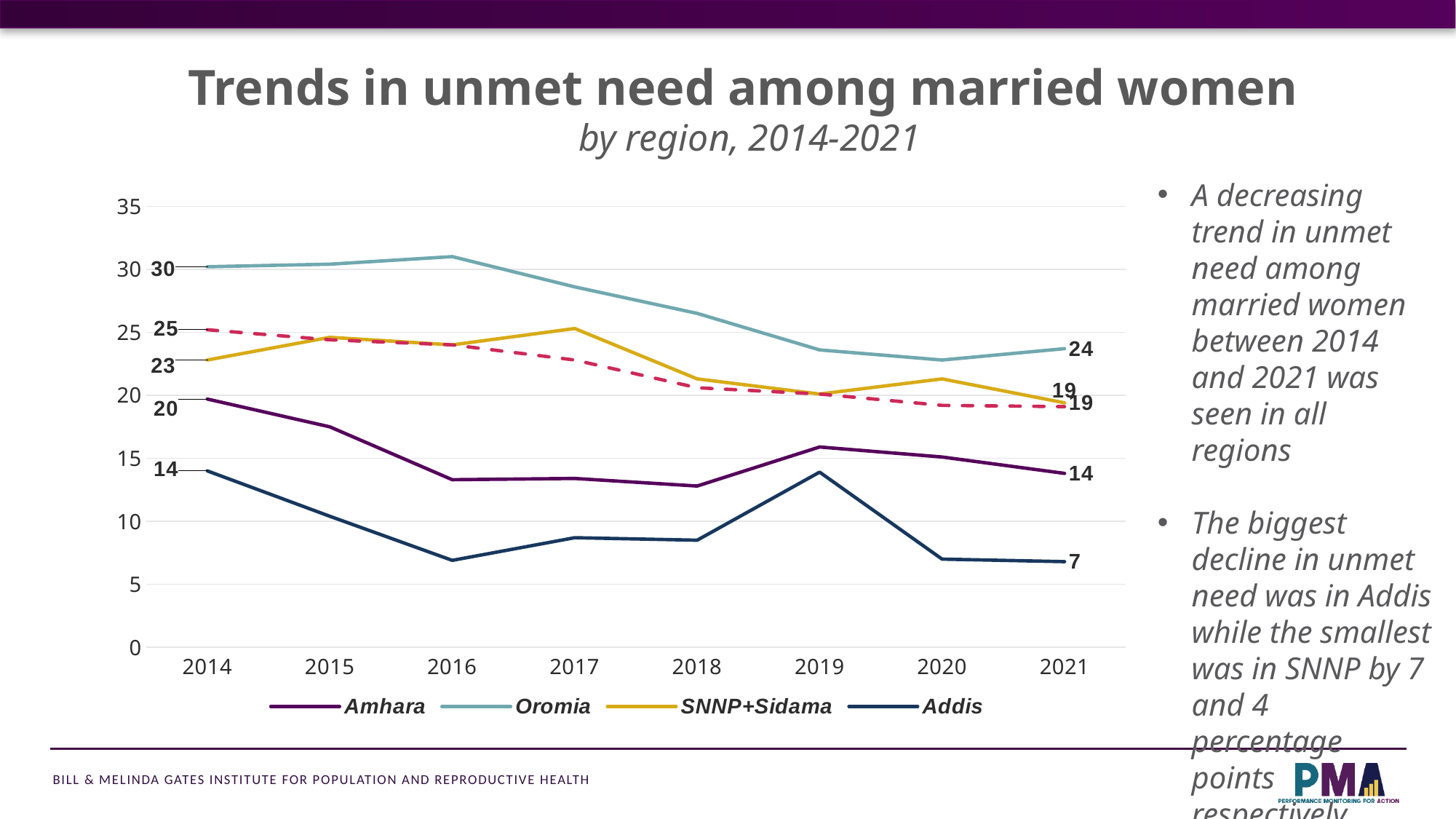
Is the value for Addis in 2016 greater or less than 10? less What kind of chart is shown on the slide? line chart How many years are shown on the x axis? 8 What was the unmet need value for Oromia in 2014? 30 What was the unmet need value for Amhara in 2014? 20 By how many points did the Addis value fall between 2014 and 2021? 7 What was the unmet need value for Addis in 2021? 7 Which region had the lowest unmet need in 2014? Addis By how many points did the Oromia value fall between 2014 and 2021? 6 How many series does the legend list? 4 What was the unmet need value for SNNP+Sidama in 2014? 23 Which region had the highest unmet need in 2021? Oromia